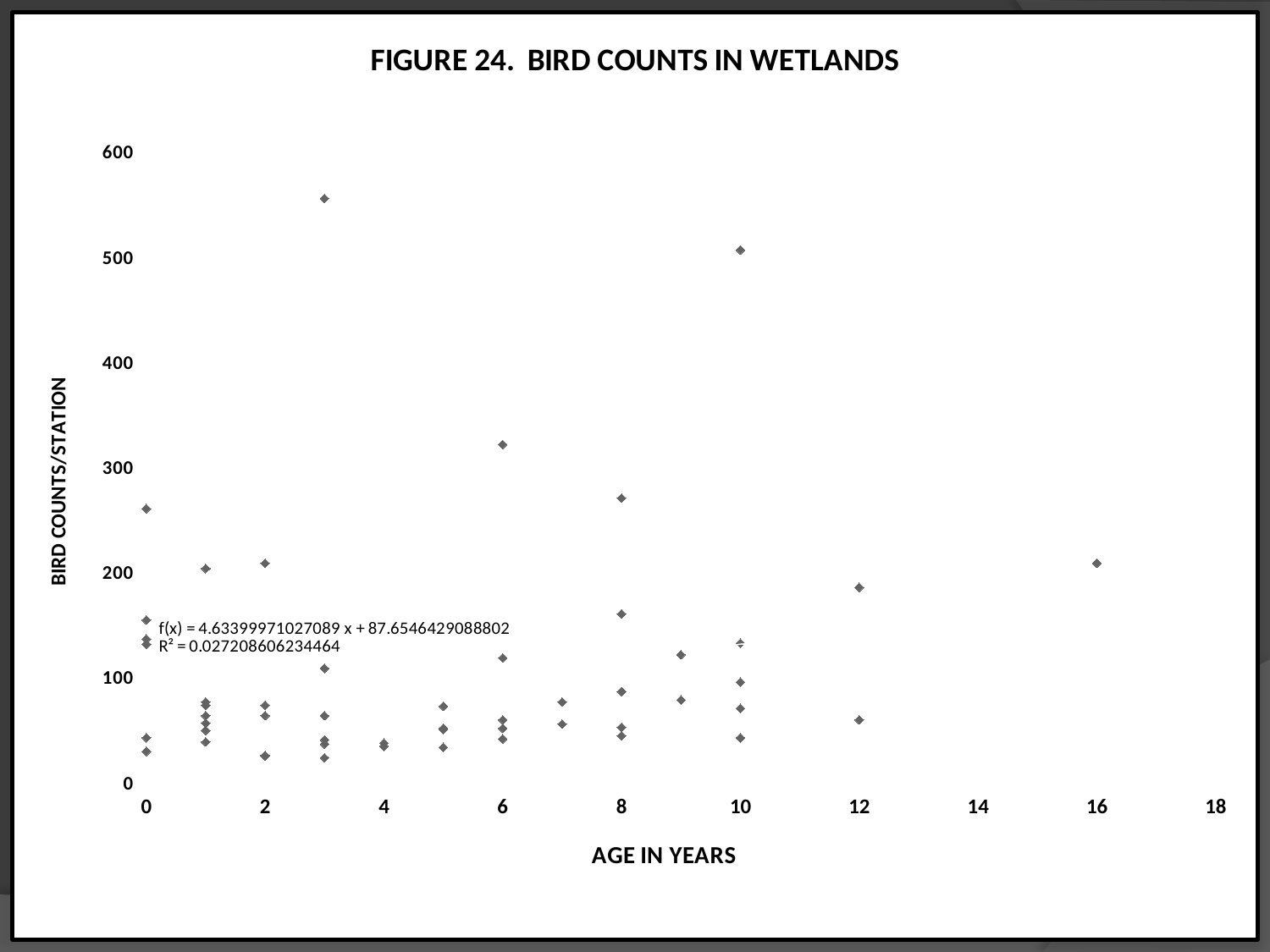
Which has the higher maximum bird count: the points at age 6 years or the points at age 8 years? age 6 years At which age in years does the single highest bird count point appear? 3 What is the title of the chart? FIGURE 24. BIRD COUNTS IN WETLANDS What kind of chart is shown on the slide? scatter chart How many data points are plotted at age 14 years? 0 What R² value is printed on the chart for the fitted line? R² = 0.027208606234464 Is the bird count plotted at age 16 years greater or less than 200? greater Is the highest bird count plotted at age 3 years greater or less than 500? greater How many data points are plotted at age 16 years? 1 Is the highest bird count plotted at age 6 years greater or less than 300? greater